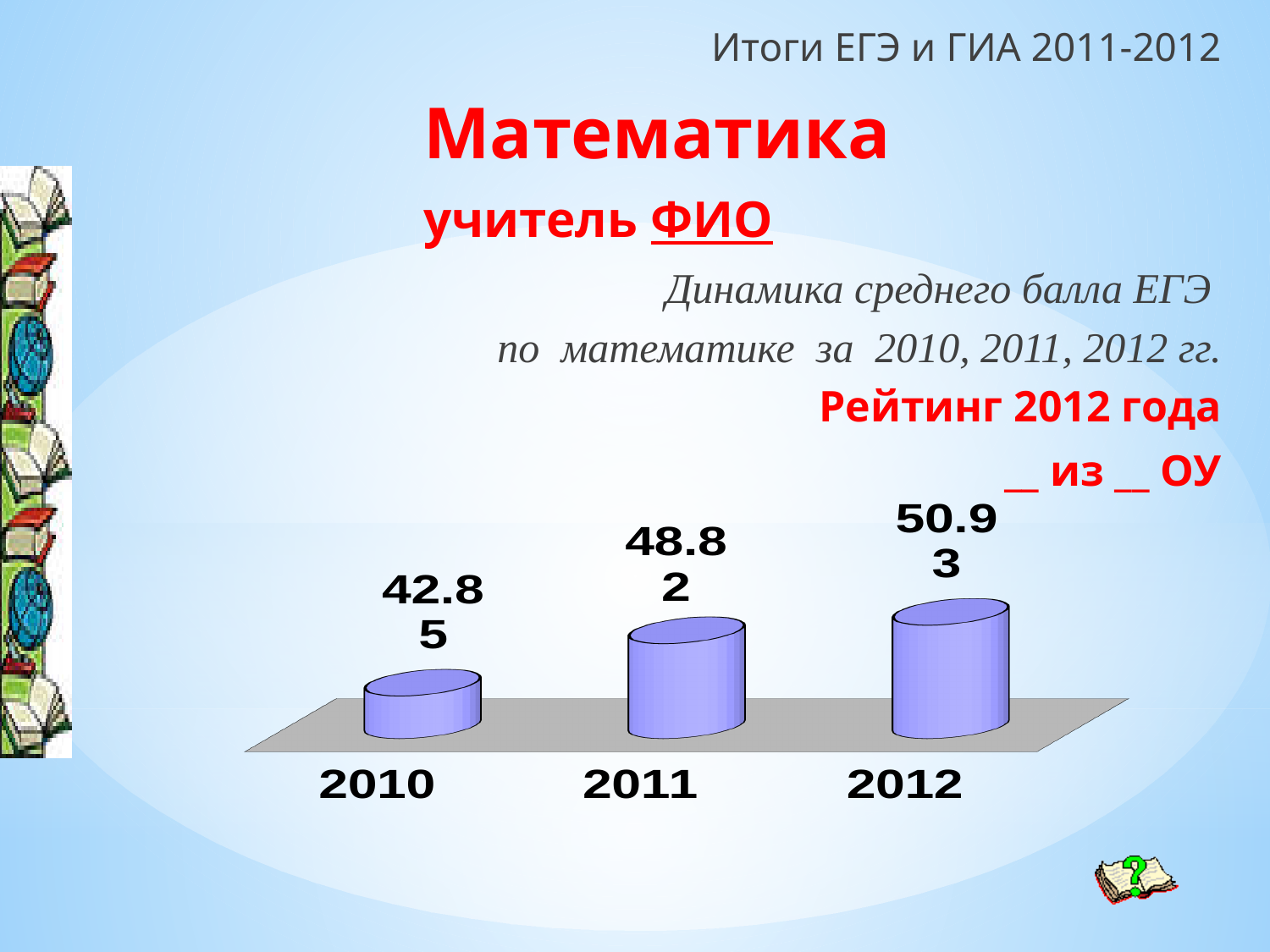
Which year has the larger average score, 2010 or 2011? 2011 What is the average EGE math score shown for 2010? 42.85 Which year has the lowest average score on the chart? 2010 How many years are plotted on the chart? 3 Which year has the highest average score on the chart? 2012 Do the average scores rise or fall from 2010 to 2012? Rise What is the average EGE math score shown for 2012? 50.93 What kind of chart is used to show the average scores? Bar chart By how much did the average score increase from 2010 to 2011? 5.97 What is the average EGE math score shown for 2011? 48.82 What is the difference between the 2012 and 2010 average scores? 8.08 By how much did the average score increase from 2011 to 2012? 2.11